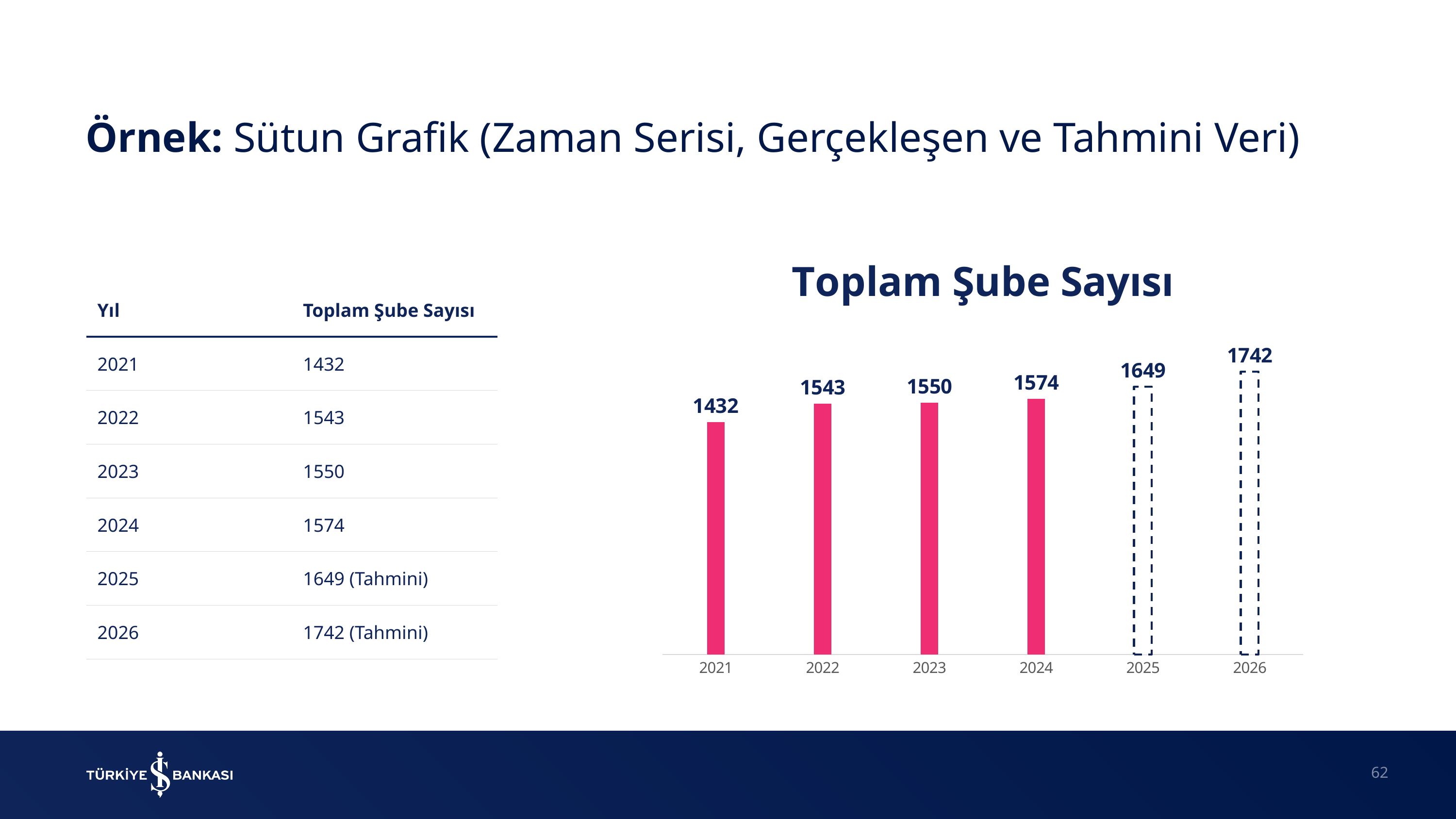
Which years are drawn with dashed outline bars instead of solid bars? 2025 and 2026 Do the values rise or fall from 2021 to 2026? Rise What is the value for 2024 in the Toplam Şube Sayısı chart? 1574 What kind of chart is shown on the slide? Bar chart Which year has the lowest value in the Toplam Şube Sayısı chart? 2021 What is the forecast value shown for 2026 in the chart? 1742 What is the value for 2021 in the Toplam Şube Sayısı chart? 1432 What is the difference between the values for 2026 and 2025? 93 What is the difference between the values for 2022 and 2021? 111 Which is larger, the value for 2023 or the value for 2024? 2024 Which year has the highest value in the Toplam Şube Sayısı chart? 2026 How many years are shown on the x axis of the chart? 6